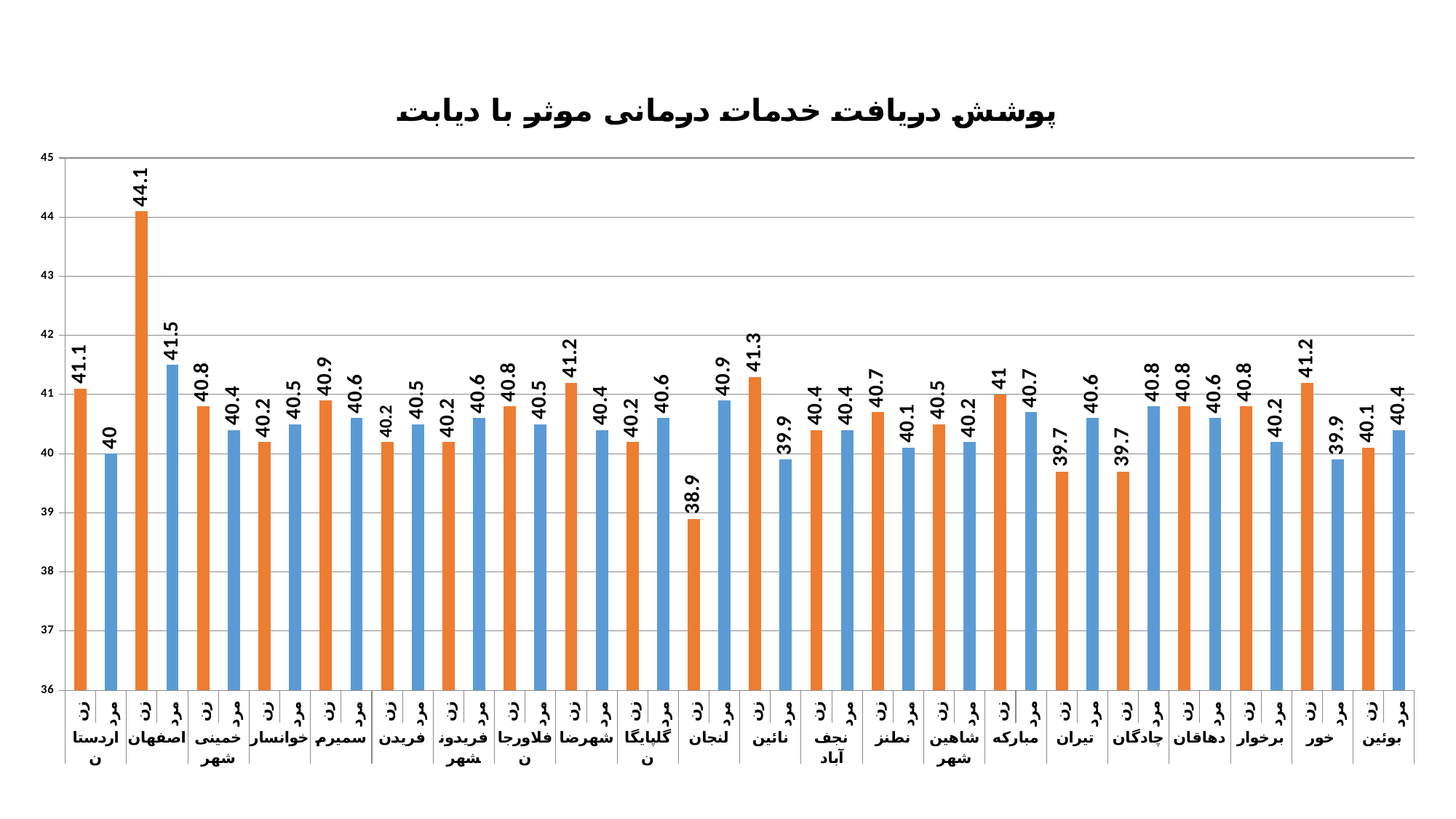
What is the value of the زن bar for اصفهان? 44.1 Is the زن value for خور greater or less than 41? greater Which bar has the lowest value in the chart? زن for لنجان (38.9) Which is larger for تیران, the زن value or the مرد value? مرد What is the difference between the زن and مرد values for اصفهان? 2.6 What is the title of the chart? پوشش دریافت خدمات درمانی موثر با دیابت What is the value of the زن bar for نائین? 41.3 How many cities (categories) are shown on the x axis? 22 What is the difference between the مرد and زن values for لنجان? 2 Which bar has the highest value in the chart? زن for اصفهان (44.1) What type of chart is shown on the slide? bar chart What is the value of the مرد bar for لنجان? 40.9